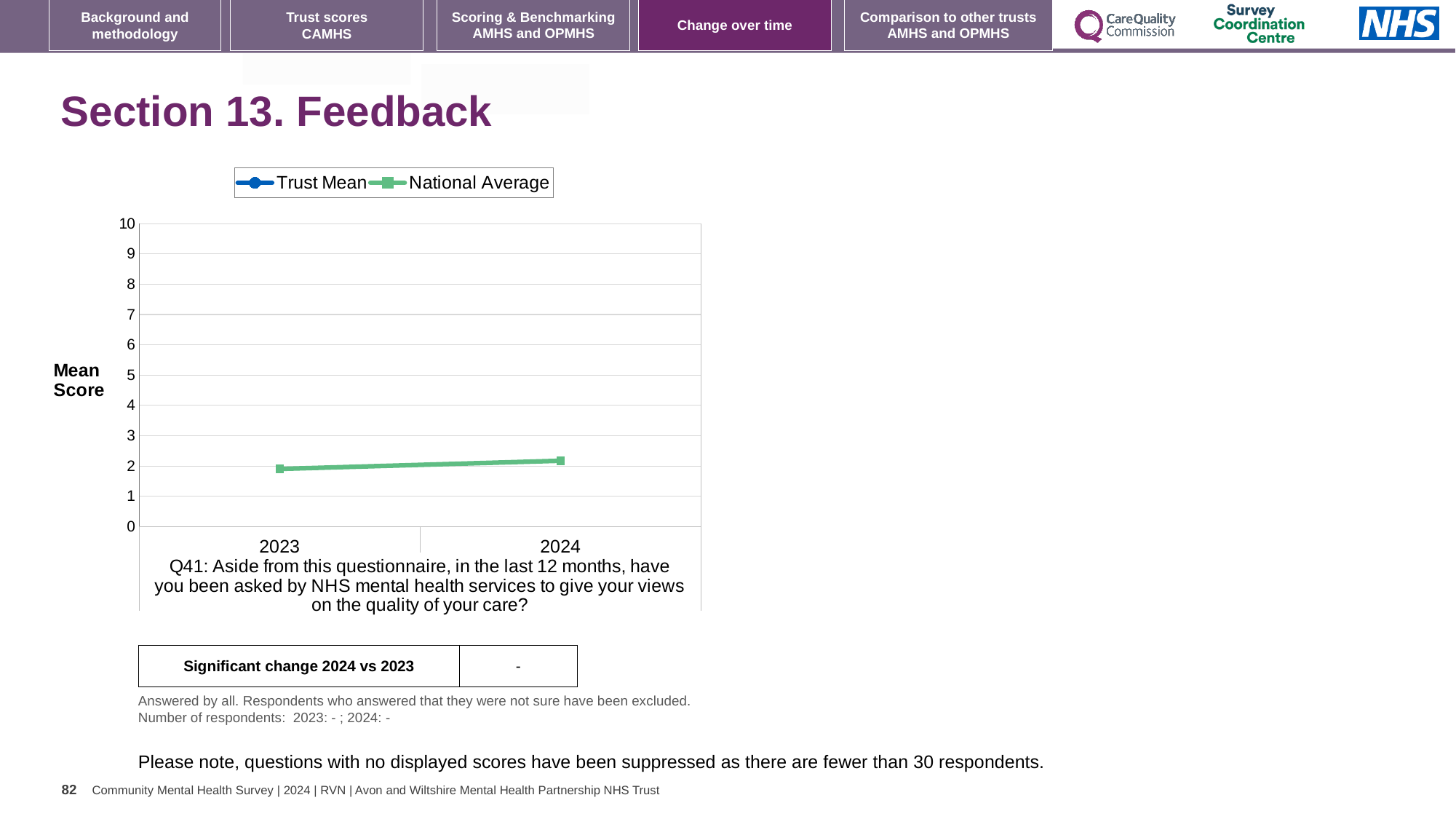
Is the National Average value for 2023 greater or less than 1? greater Which years are shown on the x axis of the chart? 2023 and 2024 What are the two series named in the chart legend? Trust Mean and National Average Is the National Average value for 2024 greater or less than 3? less Which year has the higher National Average value, 2023 or 2024? 2024 What is the maximum value shown on the y axis of the chart? 10 Is the National Average value for 2024 greater or less than 5? less How many years are shown on the x axis of the chart? 2 Does the National Average line rise or fall from 2023 to 2024? rise What kind of chart is shown on the slide? line chart How many series does the chart legend list? 2